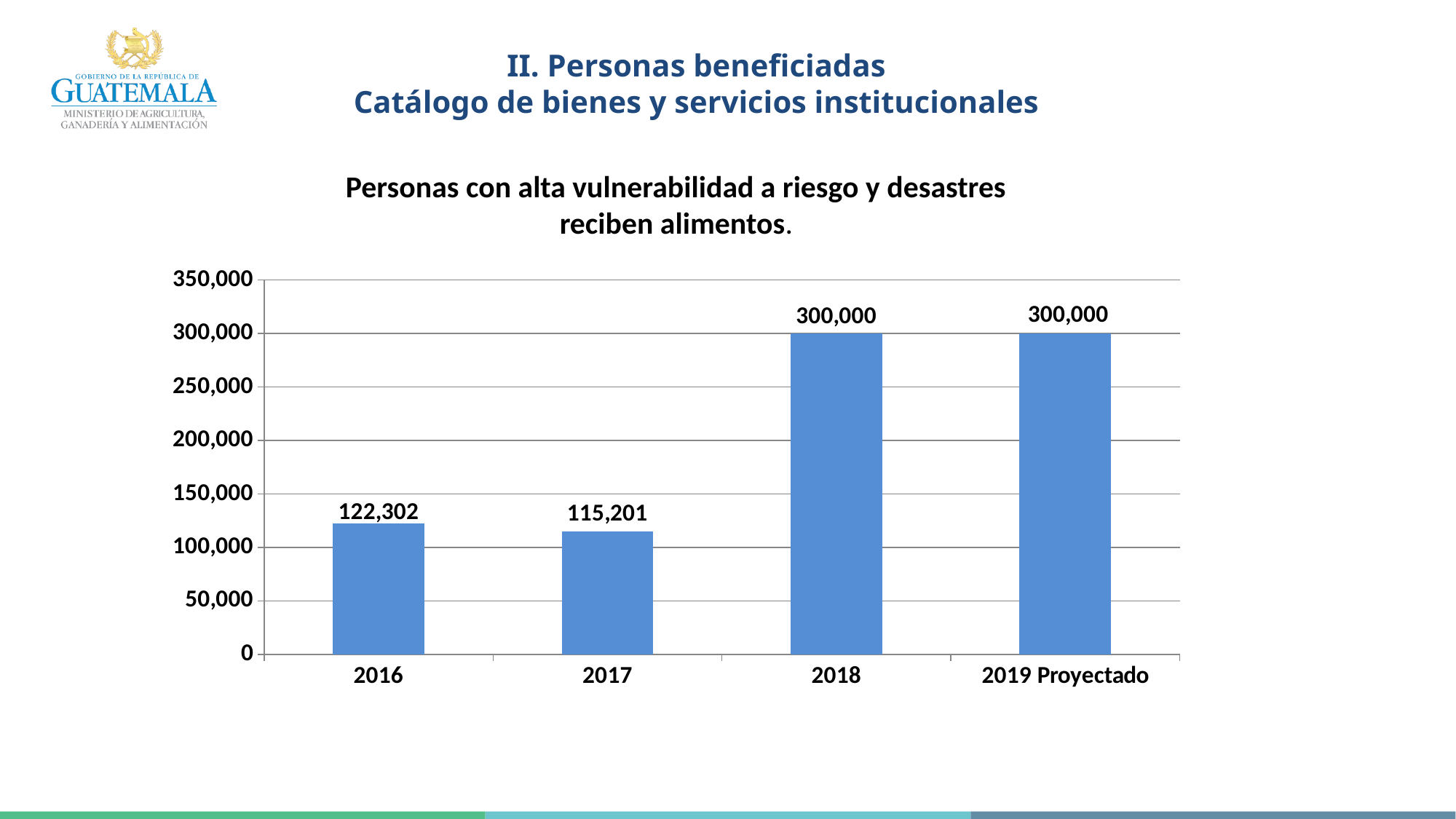
How many categories are shown on the x axis? 4 What is the value for 2018? 300,000 What is the difference between the values for 2016 and 2017? 7,101 Is the value for 2018 greater or less than 250,000? greater What is the difference between the values for 2018 and 2017? 184,799 What kind of chart is shown on the slide? bar chart What is the title of the chart? Personas con alta vulnerabilidad a riesgo y desastres reciben alimentos. What is the value for 2016? 122,302 Which category has the lowest value? 2017 What is the value for 2019 Proyectado? 300,000 What is the value for 2017? 115,201 Which is larger, the value for 2016 or the value for 2017? 2016